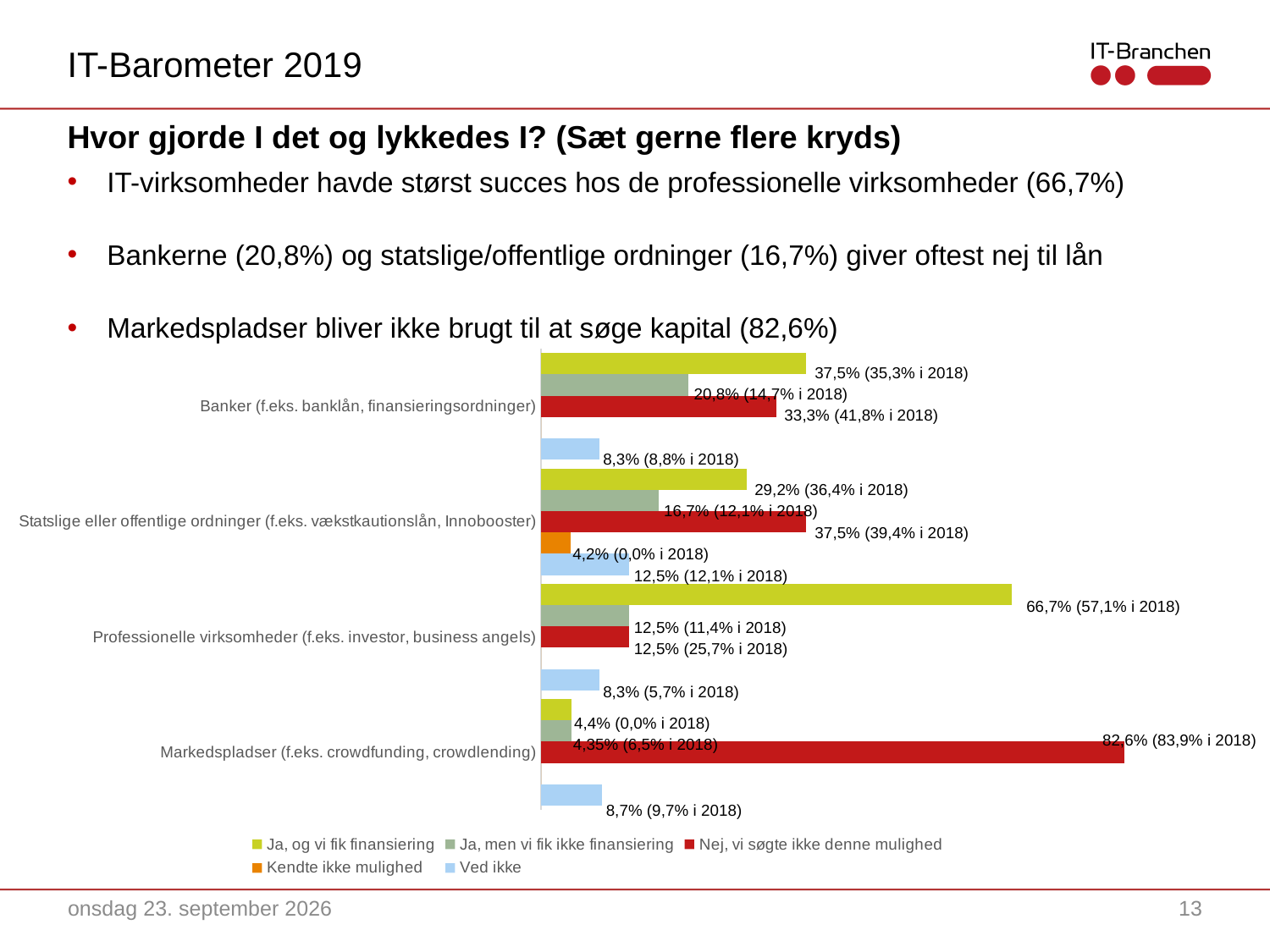
Which category has the highest value for "Ja, og vi fik finansiering"? Professionelle virksomheder (f.eks. investor, business angels) What is the "Ved ikke" value for Statslige eller offentlige ordninger? 12,5% How many categories are shown on the chart? 4 Which category has the lowest value for "Ja, og vi fik finansiering"? Markedspladser (f.eks. crowdfunding, crowdlending) For Banker, what is the difference between "Ja, og vi fik finansiering" (37,5%) and "Ja, men vi fik ikke finansiering" (20,8%)? 16,7 percentage points How many series does the legend list? 5 What kind of chart is shown on the slide? Bar chart What is the value of "Ja, og vi fik finansiering" for Professionelle virksomheder (f.eks. investor, business angels)? 66,7% According to the data label, what was the 2018 value of "Ja, og vi fik finansiering" for Professionelle virksomheder? 57,1% Which is larger: the "Nej, vi søgte ikke denne mulighed" value for Banker or for Statslige eller offentlige ordninger? Statslige eller offentlige ordninger What is the "Kendte ikke mulighed" value for Statslige eller offentlige ordninger? 4,2% What is the value of "Nej, vi søgte ikke denne mulighed" for Markedspladser (f.eks. crowdfunding, crowdlending)? 82,6%